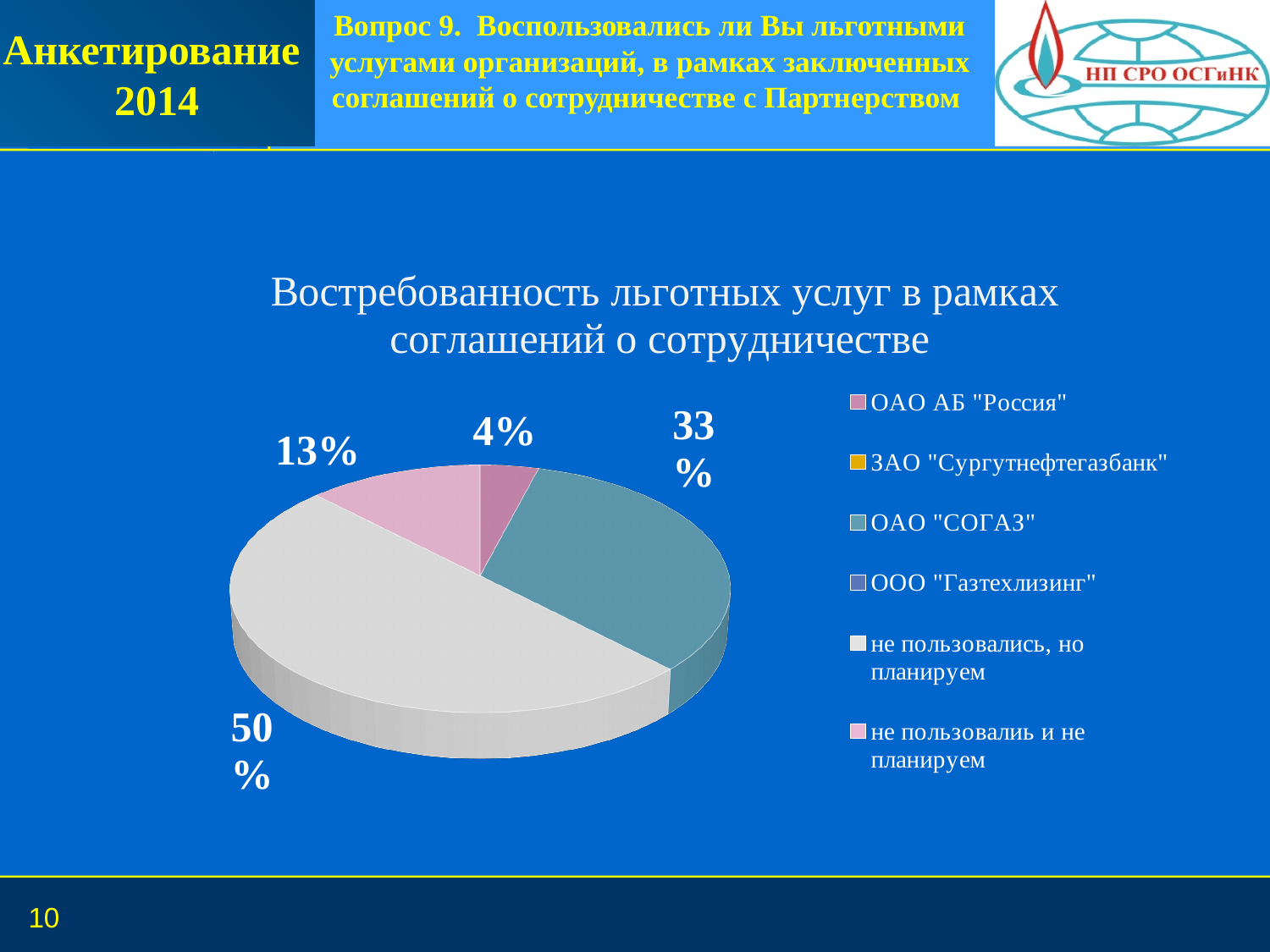
What share of the pie is labelled for ОАО АБ "Россия"? 4% What share of the pie is labelled for ОАО "СОГАЗ"? 33% What is the difference in percentage points between the "не пользовались, но планируем" slice and the ОАО "СОГАЗ" slice? 17% What kind of chart is shown on the slide? pie chart What share of the pie is labelled for "не пользовались, но планируем"? 50% Which labelled slice of the pie is the smallest? ОАО АБ "Россия" What is the title of the chart? Востребованность льготных услуг в рамках соглашений о сотрудничестве Which slice is larger: ОАО "СОГАЗ" or "не пользовалиь и не планируем"? ОАО "СОГАЗ" How many slices of the pie have a percentage label shown? 4 What share of the pie is labelled for "не пользовалиь и не планируем"? 13% How many entries does the chart legend list? 6 Which category has the largest slice of the pie? не пользовались, но планируем